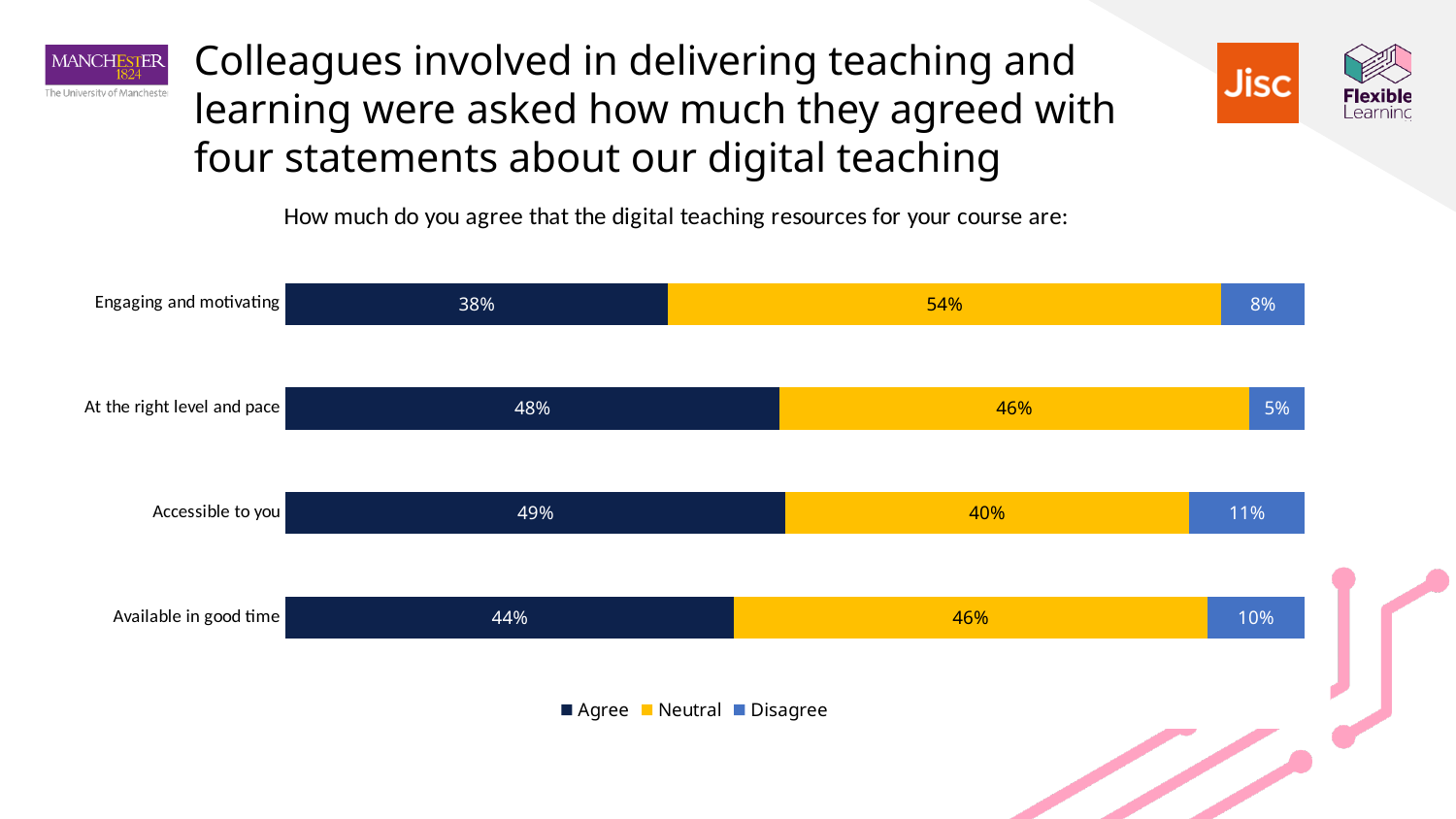
What is the difference between the Neutral values for 'Engaging and motivating' and 'Accessible to you'? 14% What is the total of the three segments for 'At the right level and pace'? 99% How many statements are shown on the chart? 4 What is the Neutral value for 'Accessible to you'? 40% What percentage disagreed that the resources are available in good time? 10% How many series does the legend list? 3 Which statement has the highest Agree percentage? Accessible to you What kind of chart is shown on the slide? Stacked bar chart Which series is shown in yellow in the legend? Neutral Is the Agree value larger for 'At the right level and pace' or for 'Available in good time'? At the right level and pace Which statement has the lowest Disagree percentage? At the right level and pace What percentage of colleagues agreed that the digital teaching resources are engaging and motivating? 38%